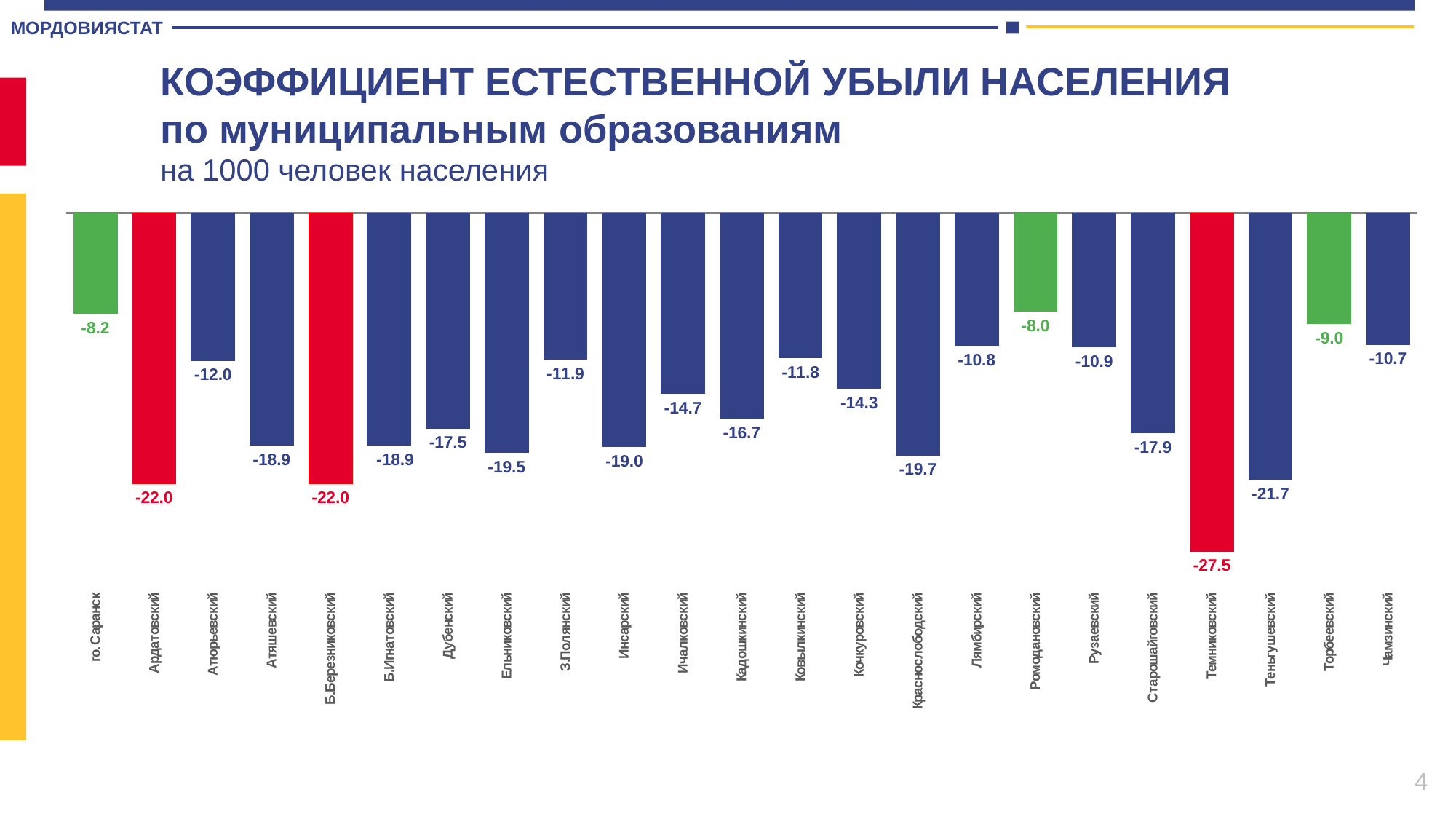
What is the value for Темниковский? -27.5 Which municipality has the lowest (most negative) value? Темниковский What is the value for го.Саранск? -8.2 What is the value for Ковылкинский? -11.8 What is the value for Краснослободский? -19.7 Which municipality has the highest (least negative) value? Ромодановский How many bars are coloured green? 3 What is the difference between the values for Темниковский and Ардатовский? 5.5 What kind of chart is shown on the slide? Bar chart Which has a more negative value, Теньгушевский or Старошайговский? Теньгушевский Which municipalities have red bars? Ардатовский, Б.Березниковский, Темниковский How many municipalities are shown on the chart? 23